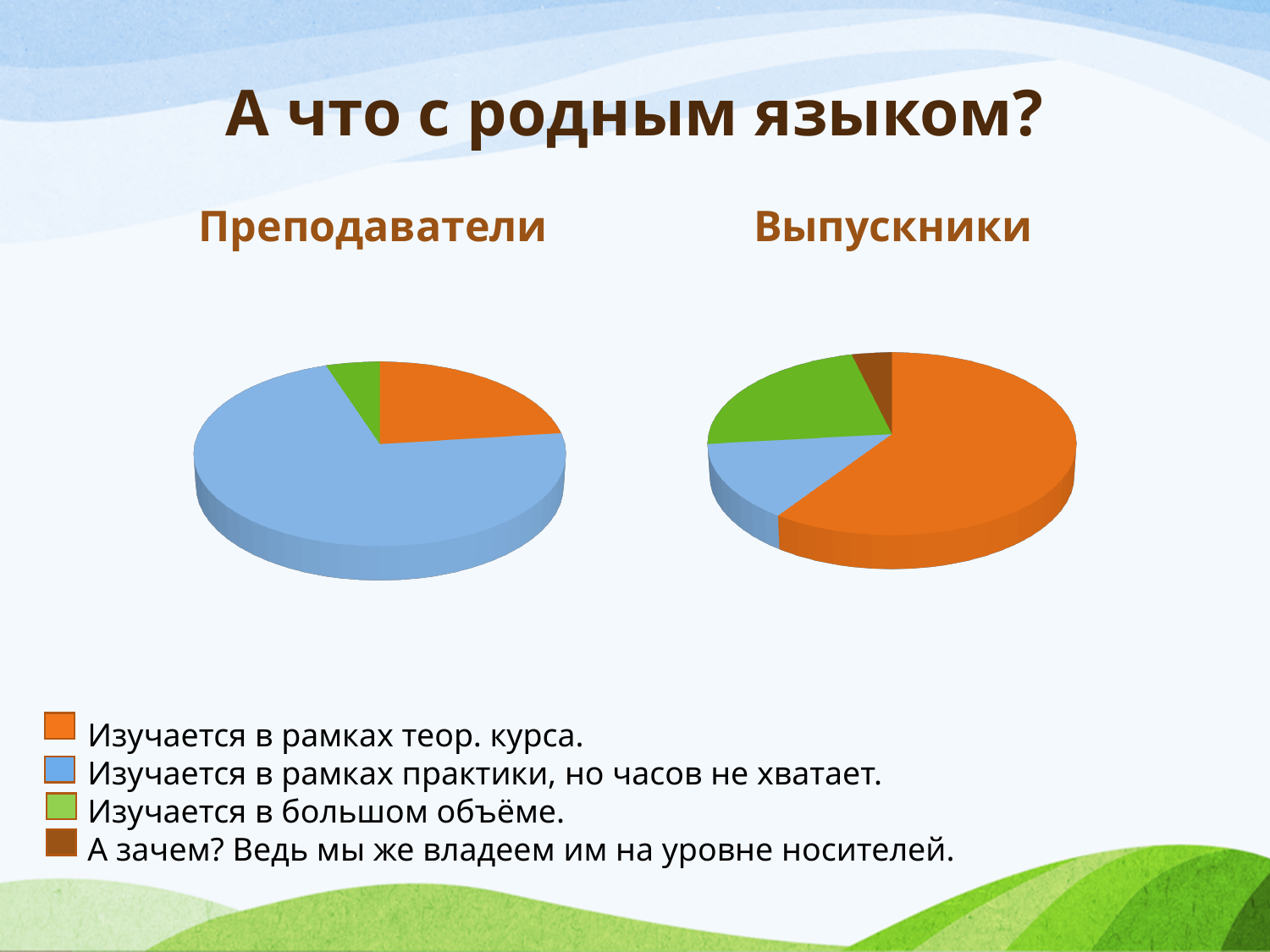
What colour represents "Изучается в рамках практики, но часов не хватает." in the legend? blue What kind of chart is the "Преподаватели" chart? pie chart In the "Преподаватели" chart, which slice is larger: "Изучается в рамках теор. курса." or "Изучается в большом объёме."? Изучается в рамках теор. курса. What kind of chart is the "Выпускники" chart? pie chart In the "Выпускники" chart, which category has the largest slice? Изучается в рамках теор. курса. In the "Выпускники" chart, which category has the smallest slice? А зачем? Ведь мы же владеем им на уровне носителей. How many slices does the "Выпускники" pie chart have? 4 Is the slice for "Изучается в рамках теор. курса." larger in the "Преподаватели" chart or in the "Выпускники" chart? Выпускники How many entries does the shared legend list? 4 How many slices does the "Преподаватели" pie chart have? 3 In the "Преподаватели" chart, which category has the largest slice? Изучается в рамках практики, но часов не хватает. In the "Преподаватели" chart, which category has the smallest slice? Изучается в большом объёме.